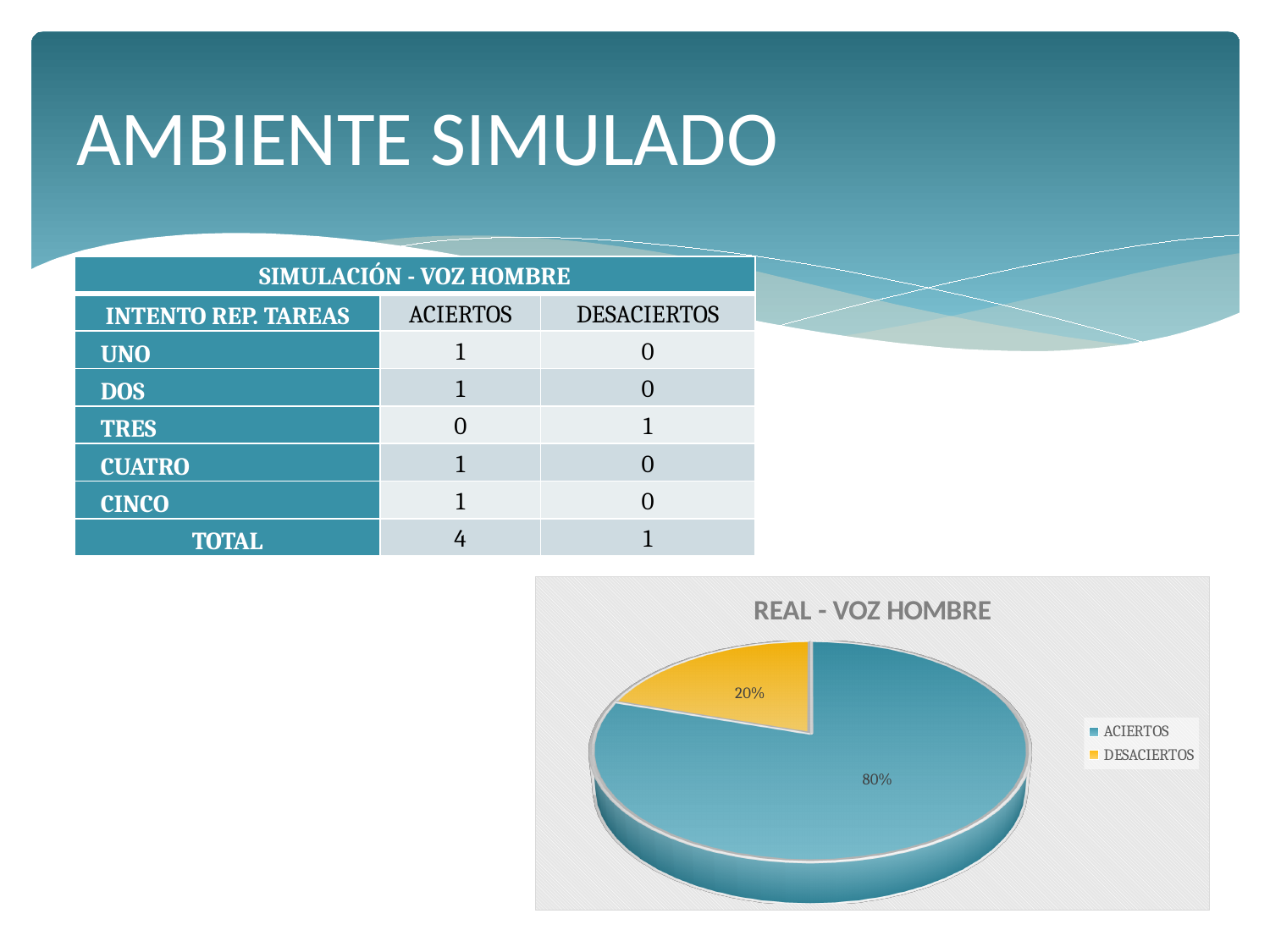
What is the difference in percentage points between the ACIERTOS and DESACIERTOS slices? 60% How many slices does the pie chart have? 2 Which slice of the pie is the largest? ACIERTOS What share of the pie does ACIERTOS take? 80% Which slice of the pie is the smallest? DESACIERTOS What is the title of the chart? REAL - VOZ HOMBRE What share of the pie does DESACIERTOS take? 20% How many entries does the legend list? 2 What colour is the DESACIERTOS slice? yellow Which is larger, the ACIERTOS slice or the DESACIERTOS slice? ACIERTOS What kind of chart is shown on the slide? pie chart